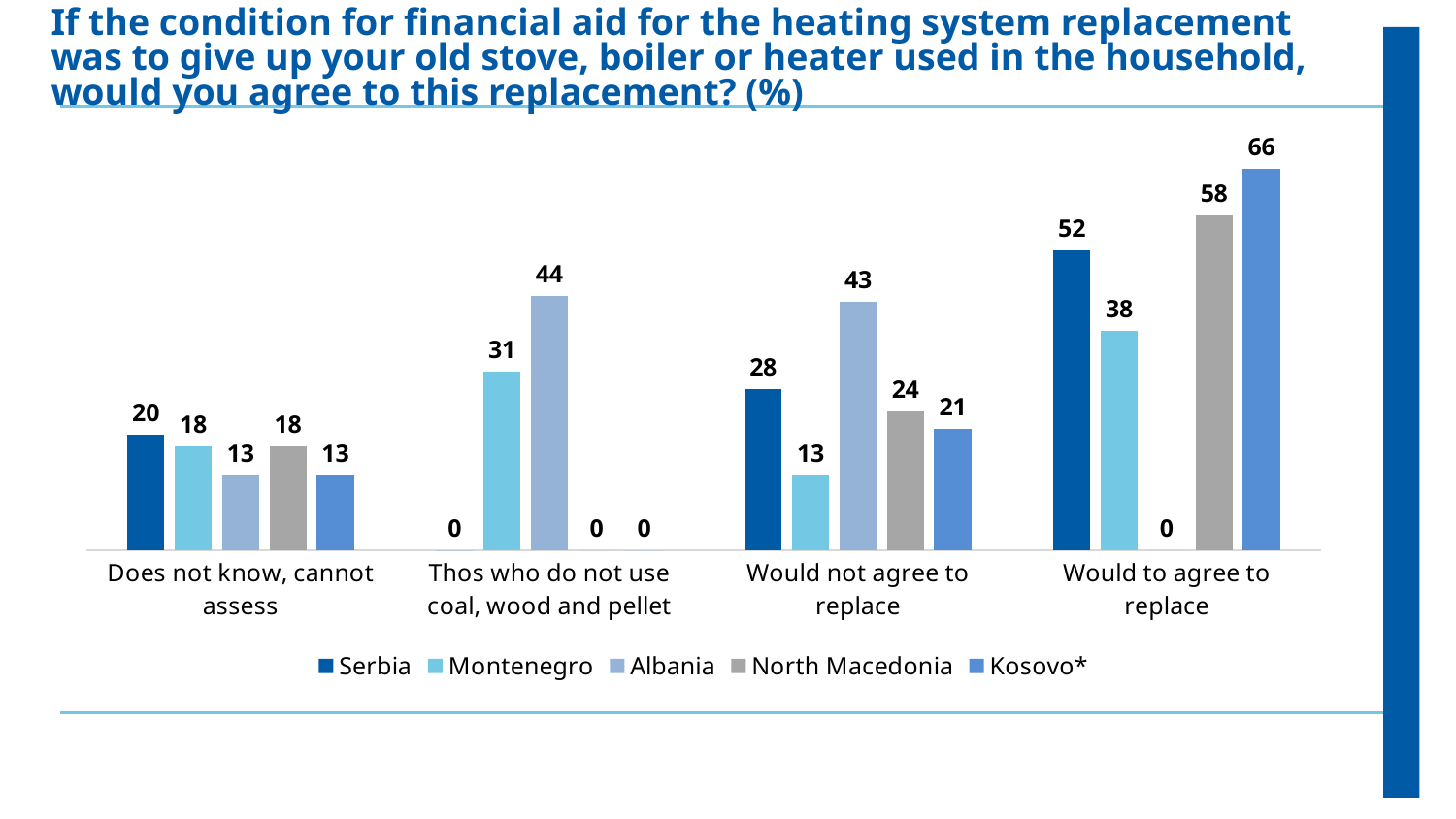
What kind of chart is shown on the slide? Bar chart What is the difference between North Macedonia and Serbia in the "Would to agree to replace" category? 6 What is the value for Montenegro in the "Thos who do not use coal, wood and pellet" category? 31 What is the value for Kosovo* in the "Would to agree to replace" category? 66 Which is larger in the "Does not know, cannot assess" category: Serbia or Albania? Serbia How many categories are shown on the x axis? 4 How many series does the legend list? 5 Which country has the lowest value in the "Would not agree to replace" category? Montenegro Which country has the highest value in the "Would to agree to replace" category? Kosovo* Which countries have a value of 0 in the "Thos who do not use coal, wood and pellet" category? Serbia, North Macedonia, Kosovo* What is the value for Albania in the "Would not agree to replace" category? 43 Which series is shown in the darkest blue colour in the legend? Serbia